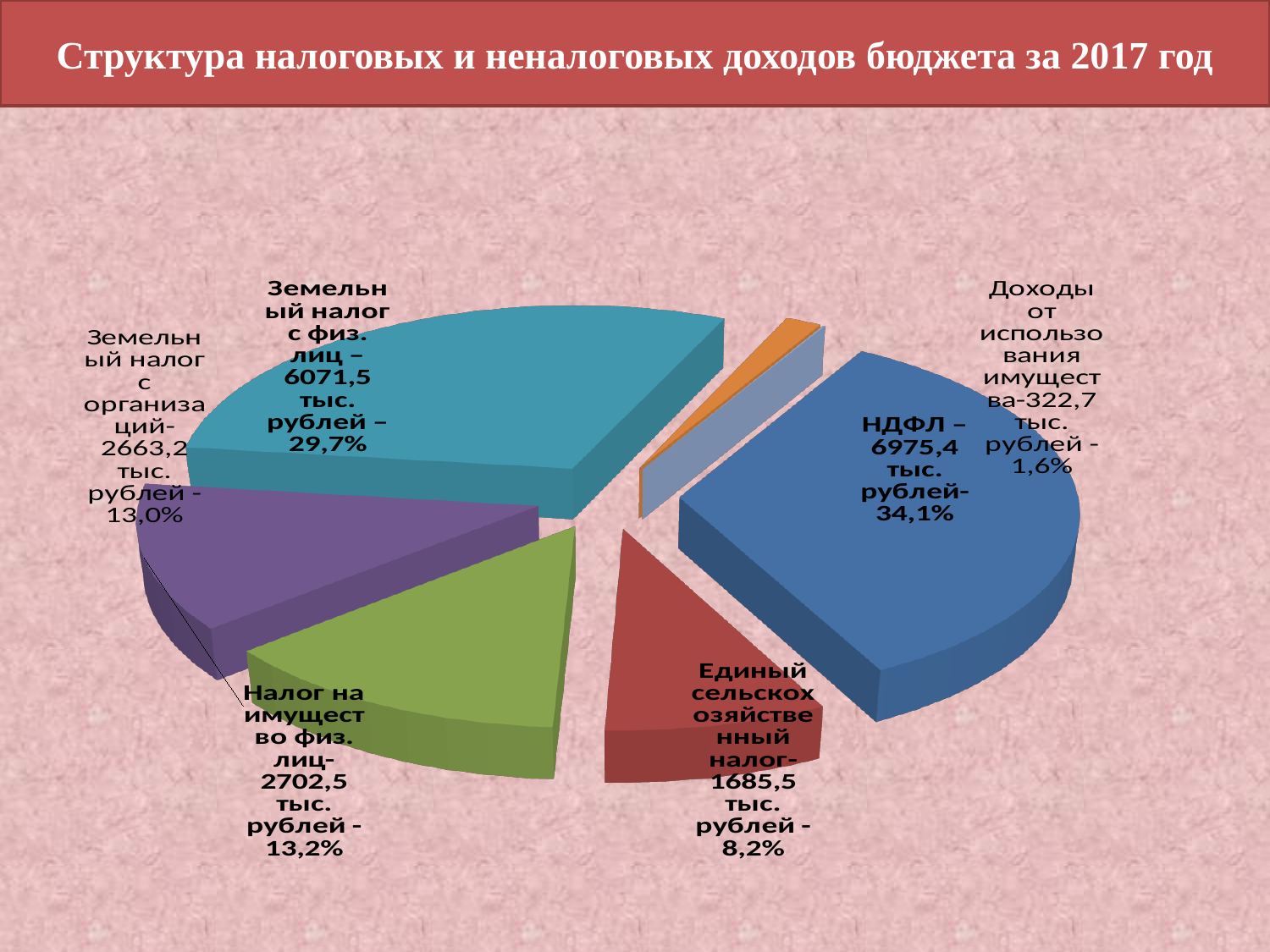
What share of the pie does Земельный налог с организаций represent? 13,0% What is the difference in value between НДФЛ and Земельный налог с физ. лиц? 903,9 тыс. рублей What kind of chart is shown on the slide? pie chart What share of the pie does Доходы от использования имущества represent? 1,6% What is the value for Земельный налог с физ. лиц? 6071,5 тыс. рублей Which is larger: Налог на имущество физ. лиц or Единый сельскохозяйственный налог? Налог на имущество физ. лиц What is the value for Единый сельскохозяйственный налог? 1685,5 тыс. рублей Which labelled category has the smallest share of the pie? Доходы от использования имущества Which labelled category has the largest share of the pie? НДФЛ What is the value for НДФЛ? 6975,4 тыс. рублей What share of the pie does НДФЛ represent? 34,1% What is the title of the chart? Структура налоговых и неналоговых доходов бюджета за 2017 год